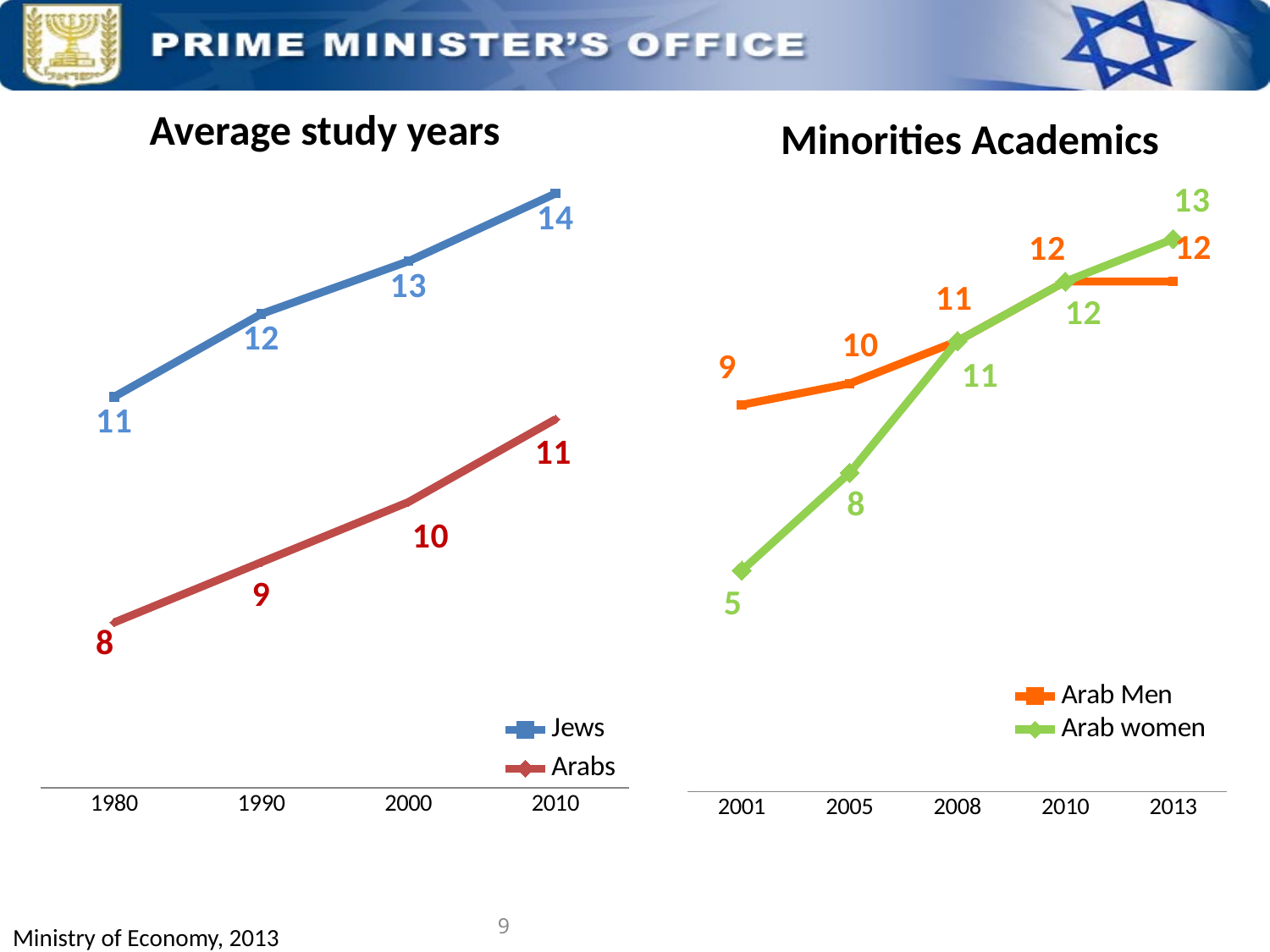
What kind of chart is the 'Minorities Academics' chart? line chart In the 'Minorities Academics' chart, what is the value for Arab women in 2005? 8 In the 'Minorities Academics' chart, in which year is the value for Arab women lowest? 2001 In the 'Average study years' chart, how many years are shown on the x axis? 4 In the 'Average study years' chart, what is the value for Jews in 2000? 13 In the 'Minorities Academics' chart, what is the difference between Arab Men and Arab women in 2001? 4 In the 'Average study years' chart, do the values for Arabs rise or fall from 1980 to 2010? rise In the 'Average study years' chart, what is the difference between Jews and Arabs in 2010? 3 In the 'Average study years' chart, how many series does the legend list? 2 In the 'Minorities Academics' chart, which series has the higher value in 2013? Arab women In the 'Minorities Academics' chart, what is the value for Arab Men in 2001? 9 In the 'Average study years' chart, what is the value for Arabs in 1980? 8